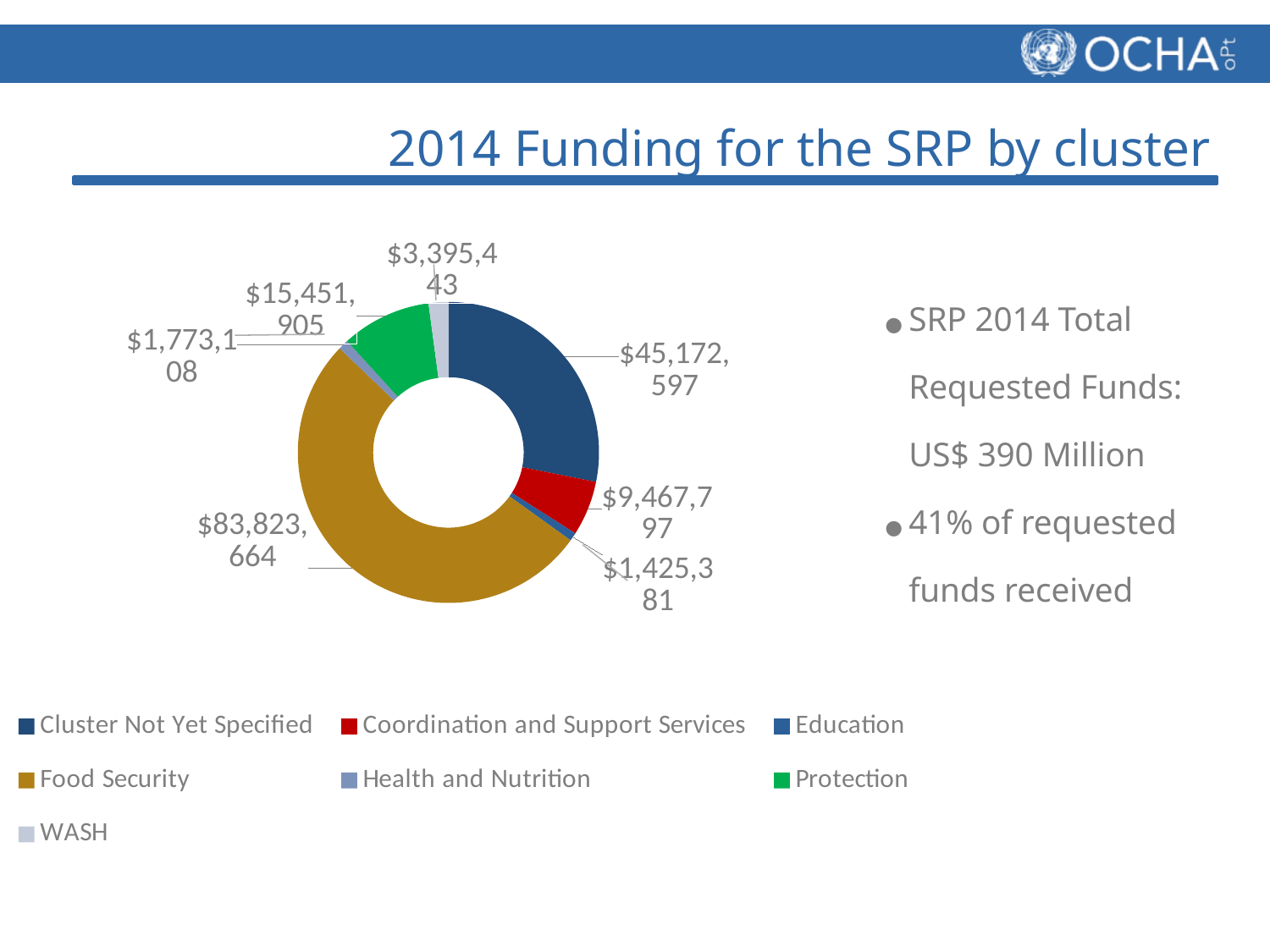
Which cluster has the largest slice? Food Security What is the value shown for Protection? $15,451,905 What is the difference between the Food Security value and the Cluster Not Yet Specified value? $38,651,067 What is the value shown for Food Security? $83,823,664 What is the value shown for Cluster Not Yet Specified? $45,172,597 What is the value shown for Coordination and Support Services? $9,467,797 Which is larger, the value for Protection or the value for Coordination and Support Services? Protection What is the title of the chart? 2014 Funding for the SRP by cluster What is the value shown for WASH? $3,395,443 How many clusters are shown in the chart? 7 What kind of chart is shown on the slide? Doughnut chart Which cluster has the smallest slice? Education